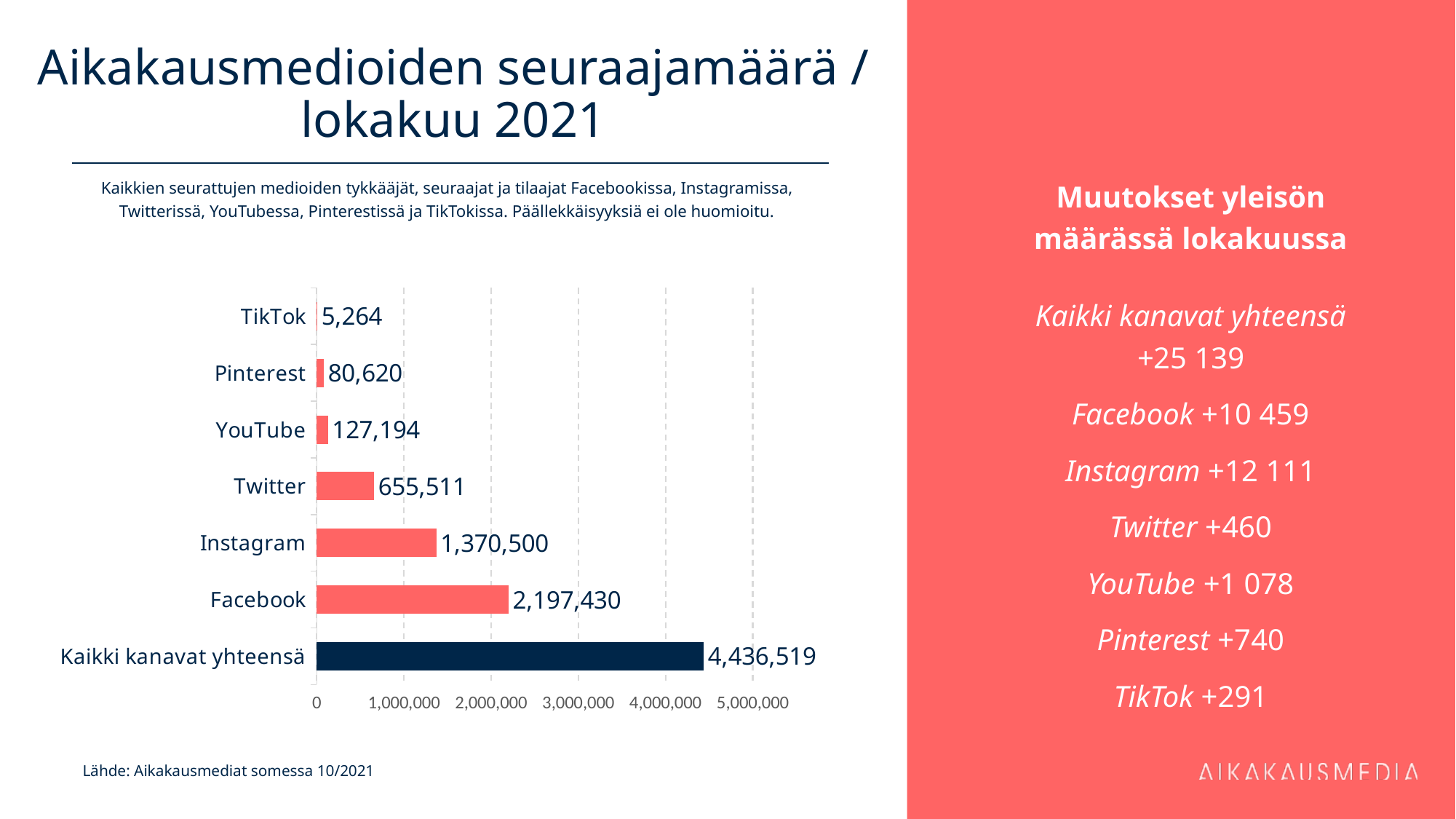
Which has a larger value, Pinterest or YouTube? YouTube What is the difference between the values for Twitter and YouTube? 528,317 What is the value shown for Facebook in the bar chart? 2,197,430 Which individual channel (excluding the total bar) has the highest value in the chart? Facebook Is the value for Twitter greater or less than 1,000,000? less What is the difference between the values for Facebook and Instagram? 826,930 What is the value shown for TikTok in the bar chart? 5,264 How many categories are shown in the bar chart? 7 What is the value shown for Kaikki kanavat yhteensä in the bar chart? 4,436,519 What kind of chart is shown on the slide? bar chart What is the value shown for Instagram in the bar chart? 1,370,500 Which category has the lowest value in the chart? TikTok